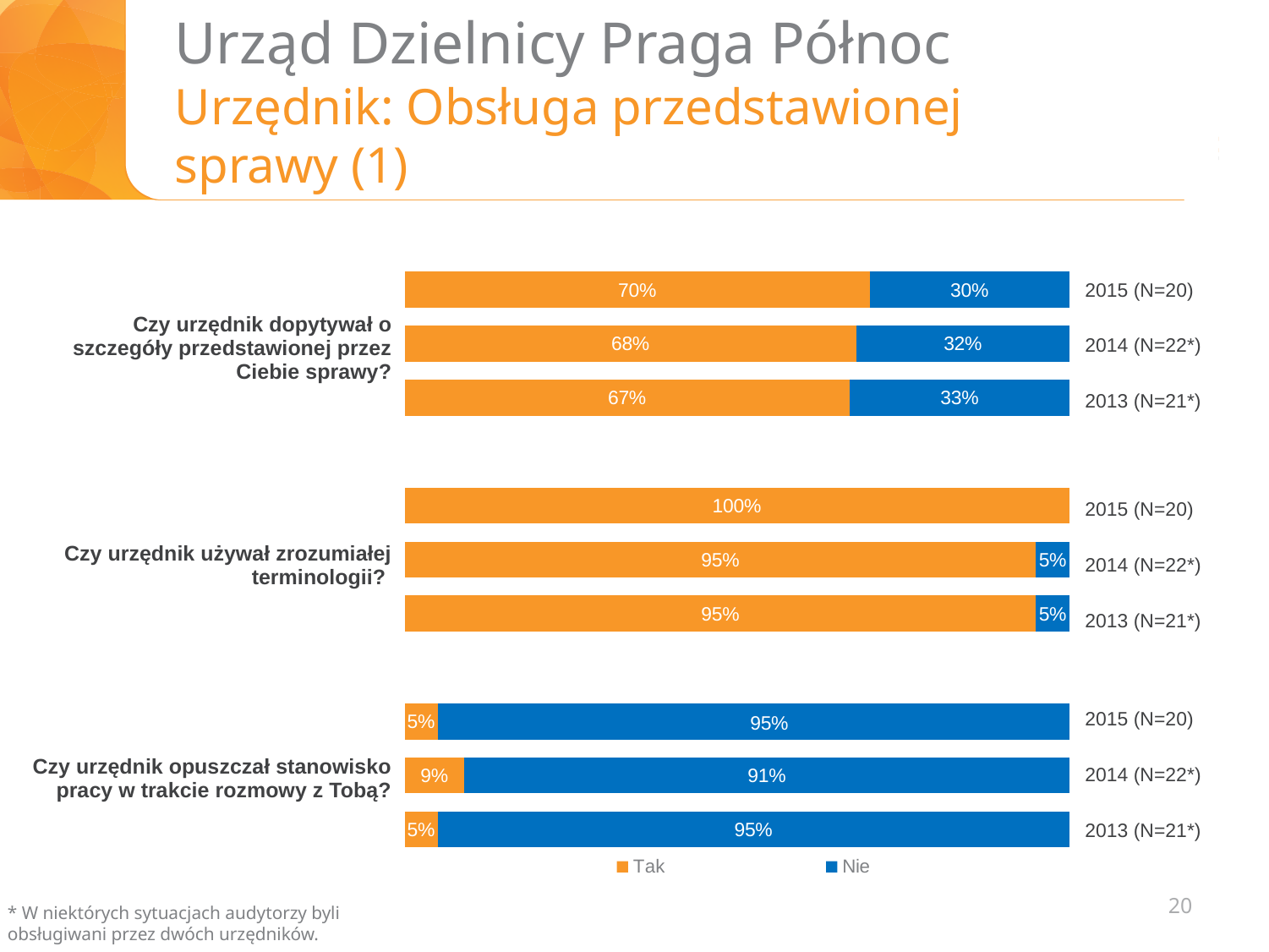
For the question 'Czy urzędnik opuszczał stanowisko pracy w trakcie rozmowy z Tobą?', which year has the lowest 'Nie' value? 2014 (N=22*) What is the 'Nie' value for 2014 (N=22*) for the question 'Czy urzędnik opuszczał stanowisko pracy w trakcie rozmowy z Tobą?' 91% How many series does the legend list? 2 What is the difference between the 'Tak' values for 2015 (N=20) and 2013 (N=21*) for the question 'Czy urzędnik dopytywał o szczegóły przedstawionej przez Ciebie sprawy?' 3 percentage points What kind of chart is shown on the slide? stacked bar chart What is the 'Tak' value for 2015 (N=20) for the question 'Czy urzędnik dopytywał o szczegóły przedstawionej przez Ciebie sprawy?' 70% How many question groups are shown in the chart? 3 What are the two series named in the legend? Tak and Nie For the question 'Czy urzędnik używał zrozumiałej terminologii?', is the 'Tak' value for 2014 (N=22*) larger or smaller than the 'Tak' value for 2015 (N=20)? smaller What is the 'Nie' value for 2013 (N=21*) for the question 'Czy urzędnik dopytywał o szczegóły przedstawionej przez Ciebie sprawy?' 33% What is the 'Tak' value for 2015 (N=20) for the question 'Czy urzędnik używał zrozumiałej terminologii?' 100% For the question 'Czy urzędnik dopytywał o szczegóły przedstawionej przez Ciebie sprawy?', which year has the highest 'Tak' value? 2015 (N=20)